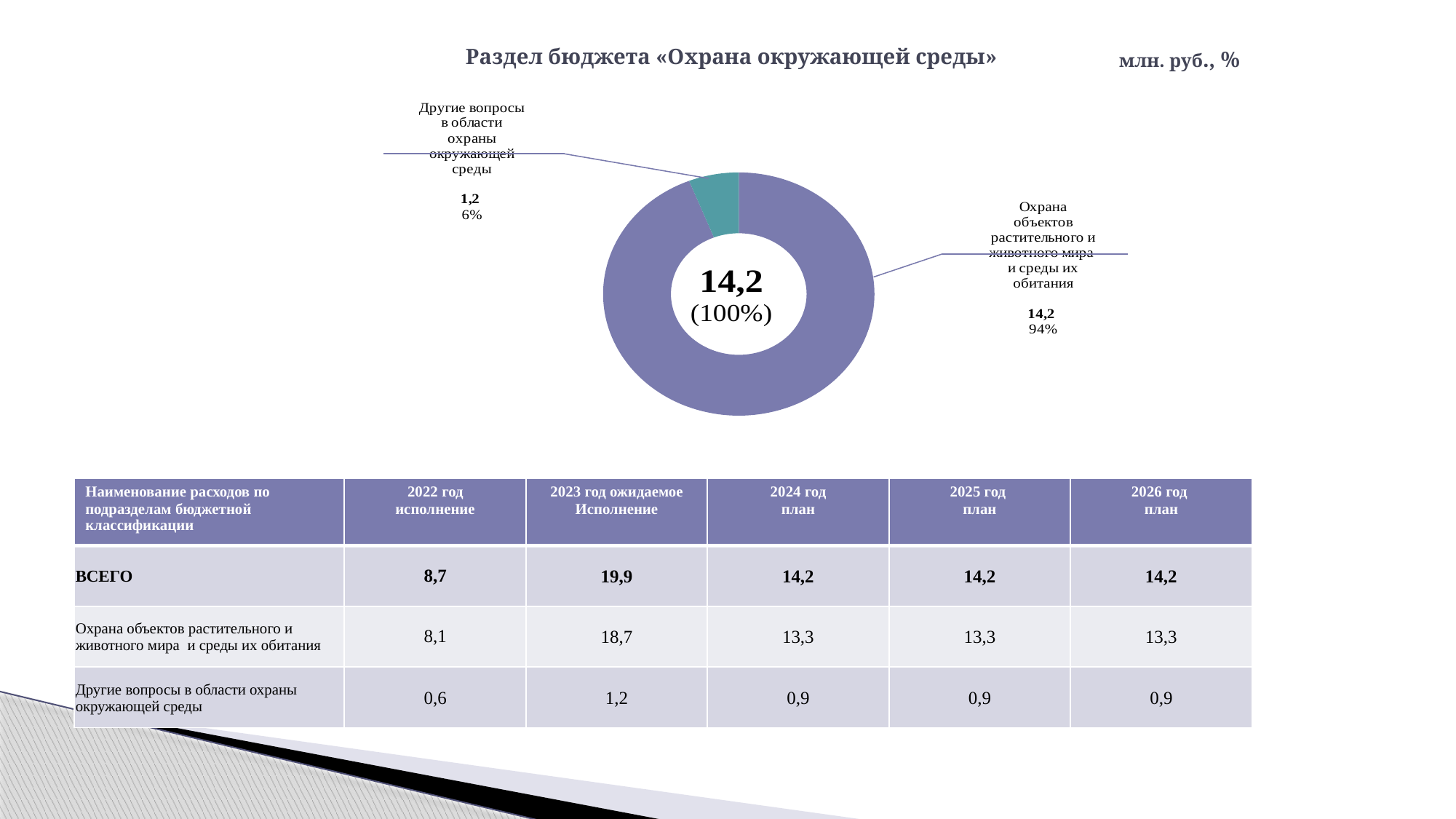
What is the title of the chart on the slide? Раздел бюджета «Охрана окружающей среды» How many slices does the doughnut chart have? 2 What share of the doughnut chart does «Охрана объектов растительного и животного мира и среды их обитания» take? 94% What value is labelled on the chart for «Другие вопросы в области охраны окружающей среды»? 1,2 What total value is shown in the centre of the doughnut chart? 14,2 (100%) What kind of chart is shown on the slide? Doughnut (pie) chart What colour is the slice for «Другие вопросы в области охраны окружающей среды» in the doughnut chart? Teal (green) Which slice of the doughnut chart is the smallest? Другие вопросы в области охраны окружающей среды Which slice of the doughnut chart is the largest? Охрана объектов растительного и животного мира и среды их обитания What value is labelled on the chart for «Охрана объектов растительного и животного мира и среды их обитания»? 14,2 Which is larger on the chart: the slice for «Охрана объектов растительного и животного мира» or the slice for «Другие вопросы в области охраны окружающей среды»? Охрана объектов растительного и животного мира What share of the doughnut chart does «Другие вопросы в области охраны окружающей среды» take? 6%